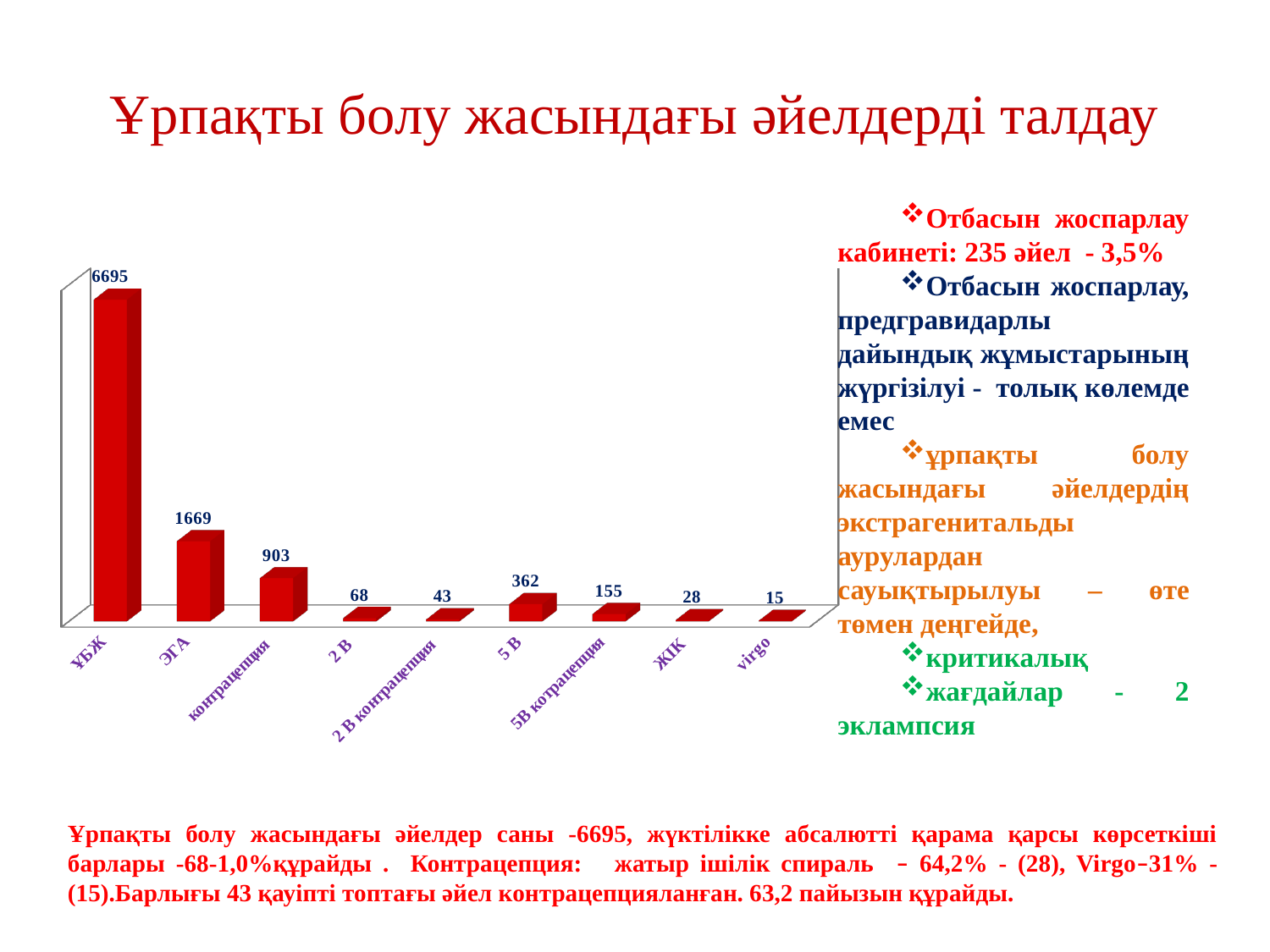
What is the value for ЭГА? 1669 What is the value for 5 В? 362 Which is larger, the value for 2 В or the value for 2 В контрацепция? 2 В What is the difference between the values for ЖІК and virgo? 13 What is the value for virgo? 15 Which category has the highest value? ҰБЖ How many categories are shown on the chart? 9 What is the value for ҰБЖ? 6695 What kind of chart is shown on the slide? bar chart What is the difference between the values for ЭГА and контрацепция? 766 What is the value for контрацепция? 903 Which category has the lowest value? virgo